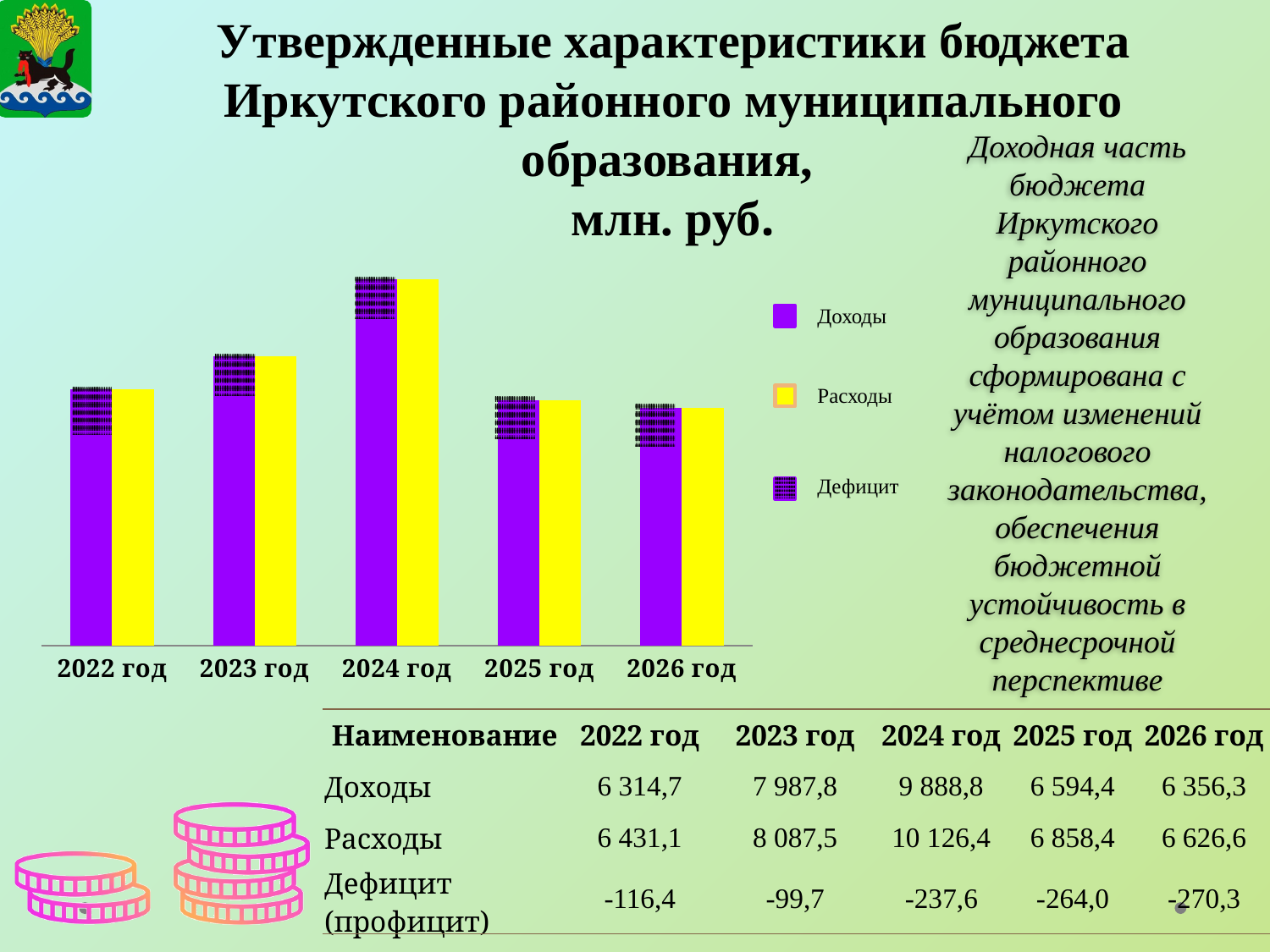
In which year are Доходы the lowest? 2022 год In which year are Расходы the highest? 2024 год How many series does the chart legend list? 3 What is the value of Дефицит (профицит) for 2026 год? -270,3 How do Доходы change from 2022 год to 2024 год? they rise What is the difference between Расходы and Доходы in 2024 год? 237,6 What is the value of Расходы for 2025 год? 6 858,4 Which is larger in 2023 год: Доходы or Расходы? Расходы What is the value of Доходы for 2024 год? 9 888,8 How many years (categories) are shown on the x axis of the chart? 5 What type of chart is shown on the slide? bar chart Which colour represents Доходы in the chart legend? purple